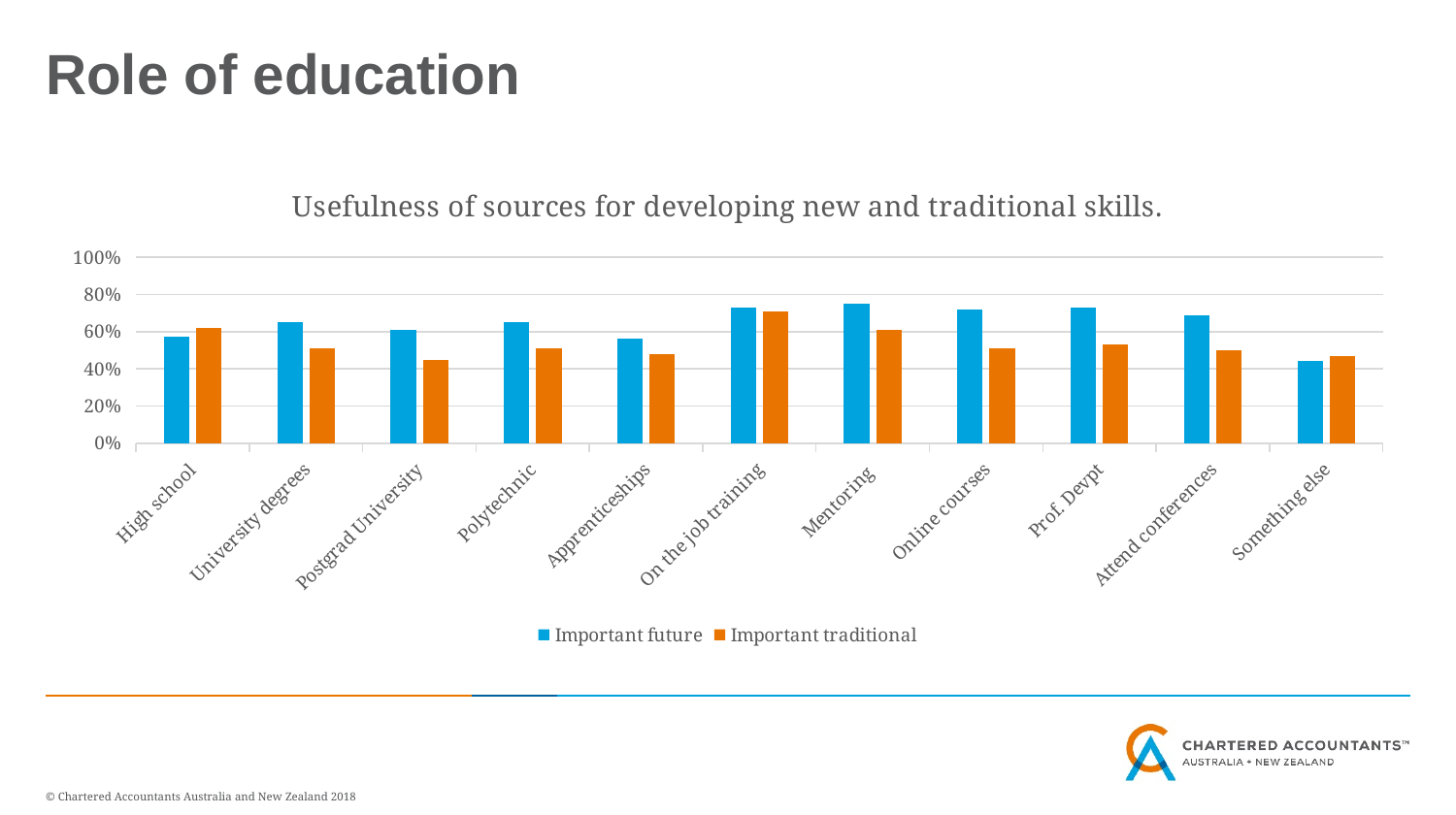
Is the Important future value for Mentoring greater or less than 60%? greater Which category has the lowest value for Important future? Something else What kind of chart is shown on the slide? bar chart How many series does the legend list? 2 For High school, which is larger: Important future or Important traditional? Important traditional Is the Important traditional value for Postgrad University greater or less than 60%? less For University degrees, which is larger: Important future or Important traditional? Important future Is the Important future value for Something else greater or less than 60%? less How many categories are shown on the x axis? 11 What is the title of the chart? Usefulness of sources for developing new and traditional skills. Which series is shown in orange? Important traditional Which category has the highest value for Important traditional? On the job training